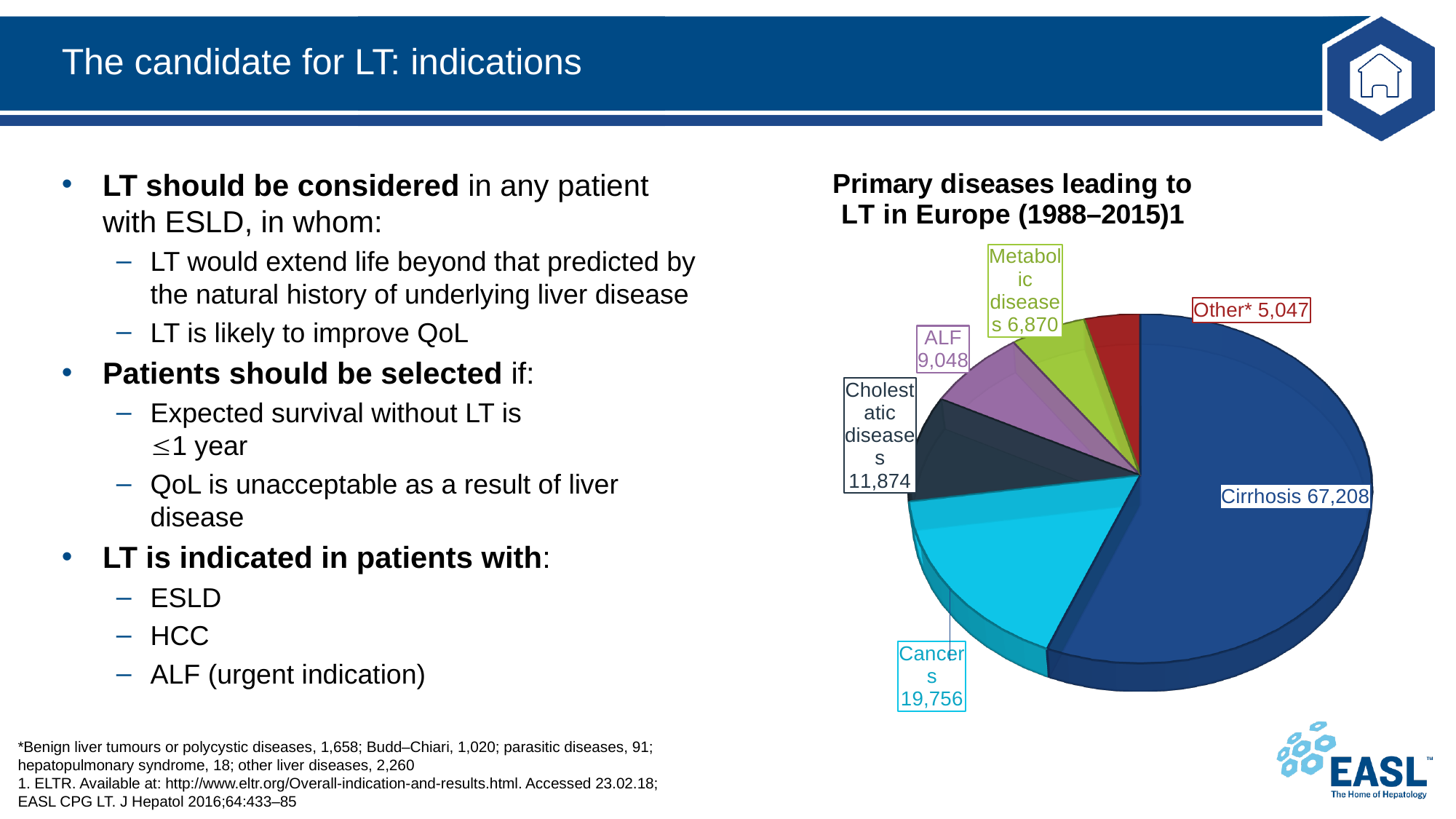
How many categories are shown in the pie chart? 6 What is the value for ALF in the pie chart? 9,048 What type of chart is shown on the slide? Pie chart Which category has the largest slice in the pie chart? Cirrhosis What is the difference between the values for Cirrhosis and Cancers? 47,452 Which category has the smallest slice in the pie chart? Other* What is the value for Cirrhosis in the pie chart? 67,208 What is the title of the pie chart? Primary diseases leading to LT in Europe (1988–2015) What is the value for Cancers in the pie chart? 19,756 What is the value for Metabolic diseases in the pie chart? 6,870 What is the value for Cholestatic diseases in the pie chart? 11,874 Which is larger, the value for ALF or the value for Metabolic diseases? ALF